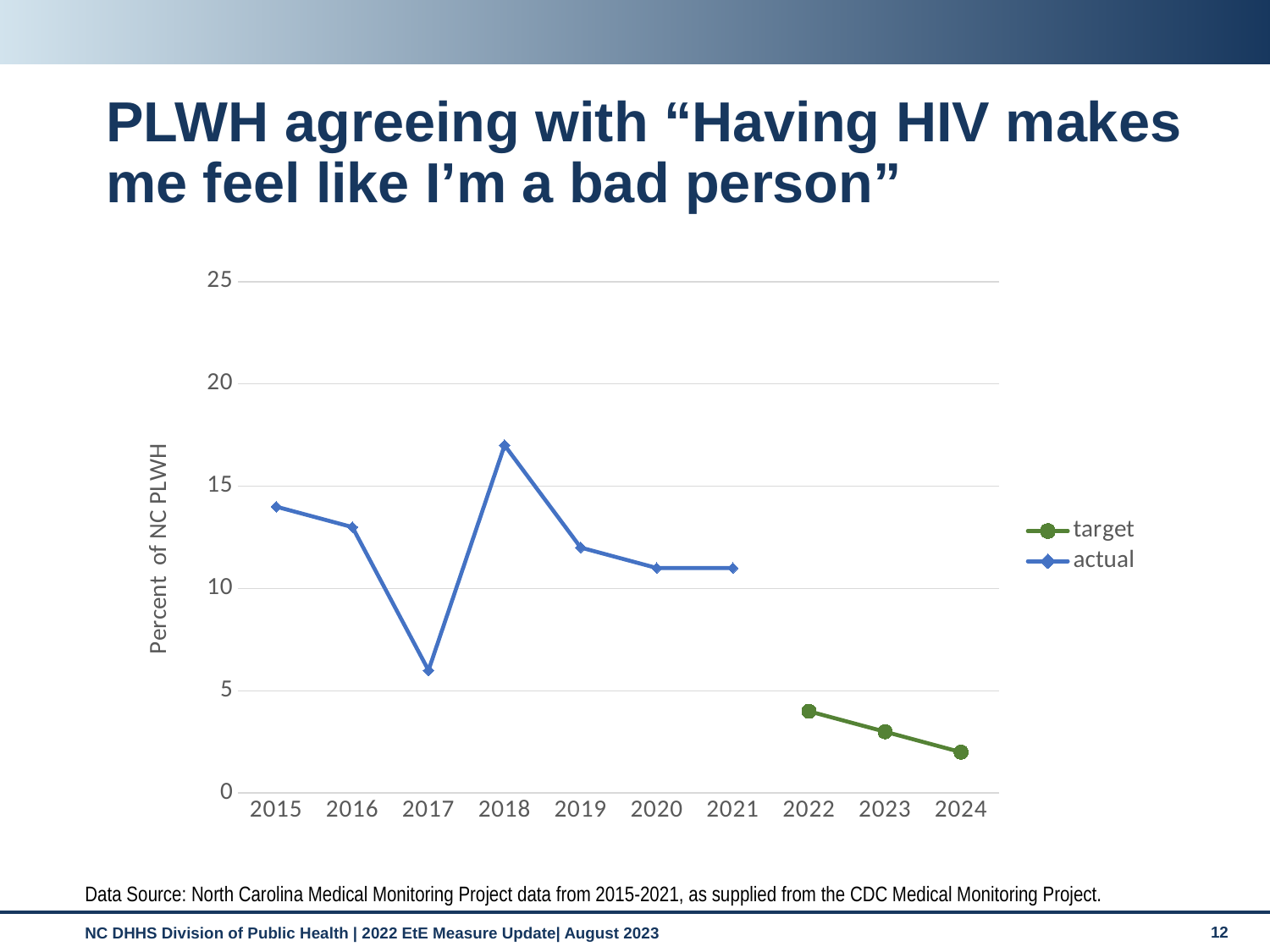
How many series does the legend list? 2 What kind of chart is shown on the slide? line chart Does the target series rise or fall from 2022 to 2024? fall In which year is the actual value lowest? 2017 How many data points does the actual series have? 7 Is the target value for 2022 greater or less than 5? less Is the actual value for 2018 greater or less than 15? greater In which year is the actual value highest? 2018 Is the actual value for 2017 greater or less than 10? less Which is larger, the actual value for 2015 or the actual value for 2017? 2015 What are the two series named in the legend? target and actual How many years are shown on the x axis? 10